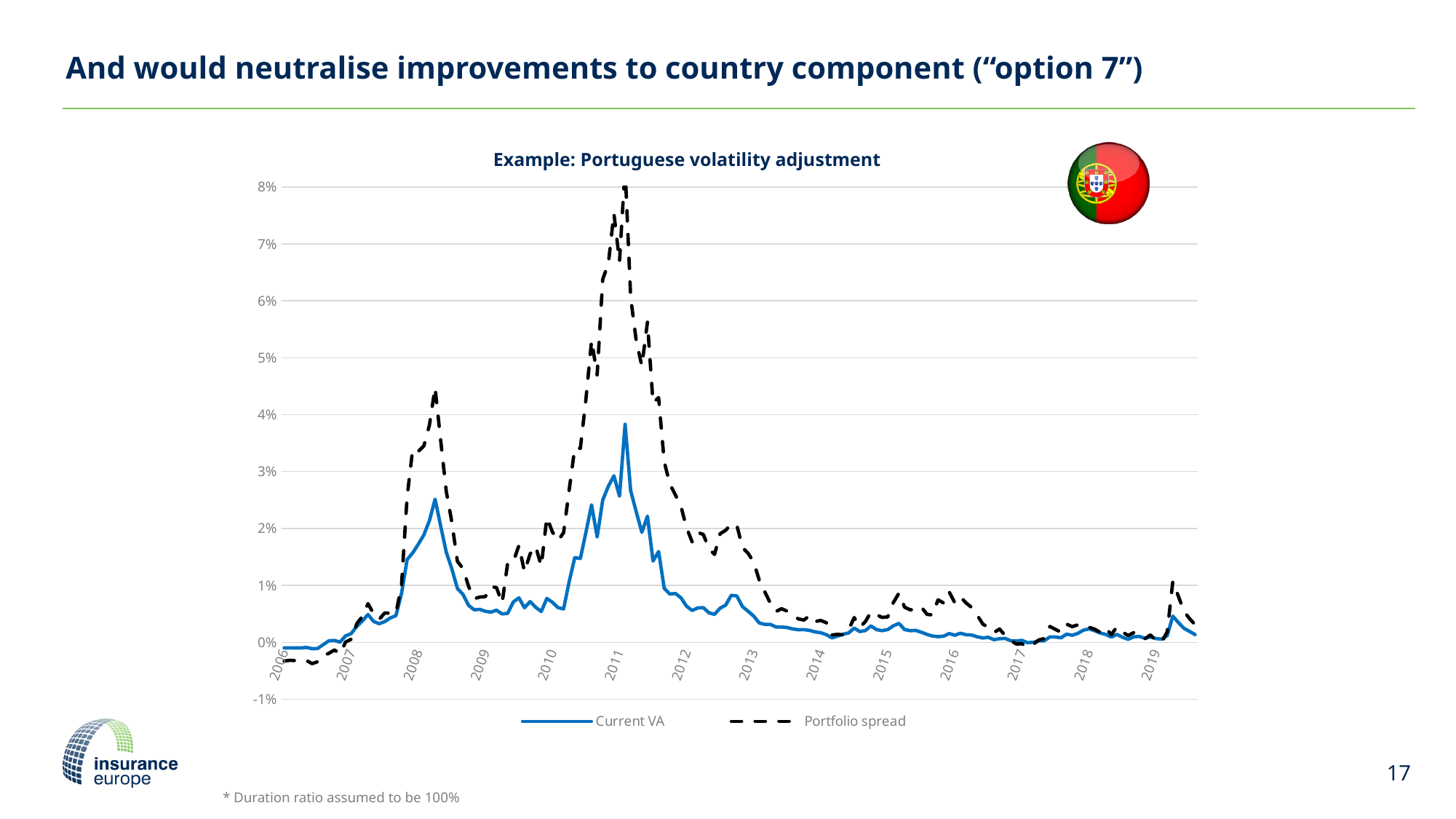
Is the value of Current VA in 2017 greater or less than 1%? less Which series reaches the higher peak overall? Portfolio spread How many year labels are shown on the x axis? 14 What kind of chart is shown on the slide? line chart From its 2011 peak to 2014, does the Current VA series rise or fall? fall What are the two series named in the legend? Current VA and Portfolio spread What is the title of the chart? Example: Portuguese volatility adjustment Is the peak value of Current VA in 2008 greater or less than 3%? less Is the peak value of Portfolio spread in 2011 greater or less than 7%? greater How many series does the legend list? 2